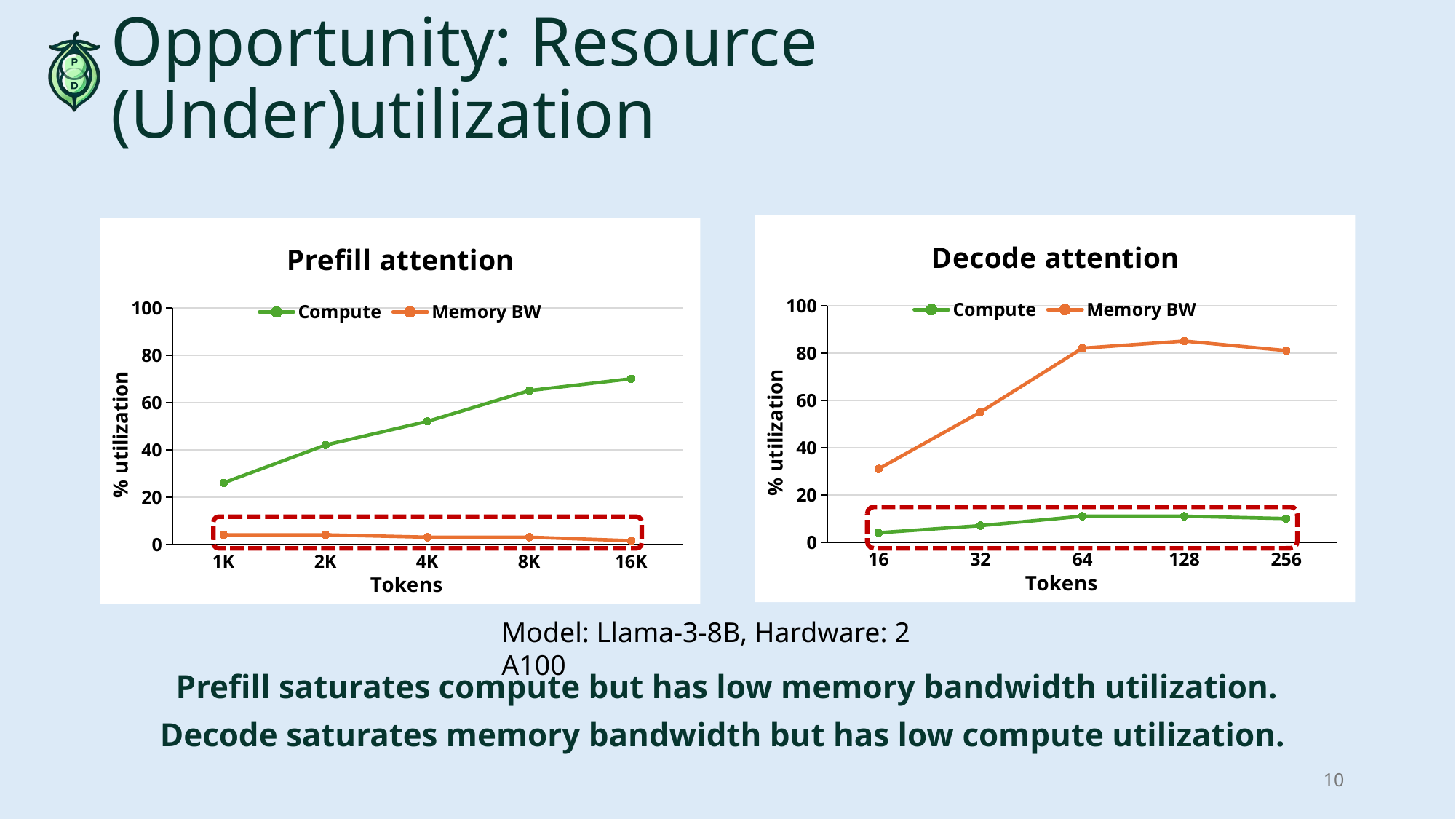
In the Decode attention chart, is the Memory BW value at 64 tokens greater or less than 60? greater How many token values are plotted along the x axis of the Prefill attention chart? 5 In the Prefill attention chart, which series is higher at 8K tokens, Compute or Memory BW? Compute In the Prefill attention chart, at which token count is Compute utilization highest? 16K What kind of chart is the Prefill attention chart? line chart What are the two legend entries in the Decode attention chart? Compute and Memory BW In the Prefill attention chart, does the Compute series rise or fall as Tokens increase from 1K to 16K? rise How many series does the legend of the Decode attention chart list? 2 In the Decode attention chart, at which token count is Memory BW utilization lowest? 16 In the Decode attention chart, is the Memory BW value at 16 tokens greater or less than 40? less In the Prefill attention chart, is the Compute value at 16K tokens greater or less than 60? greater